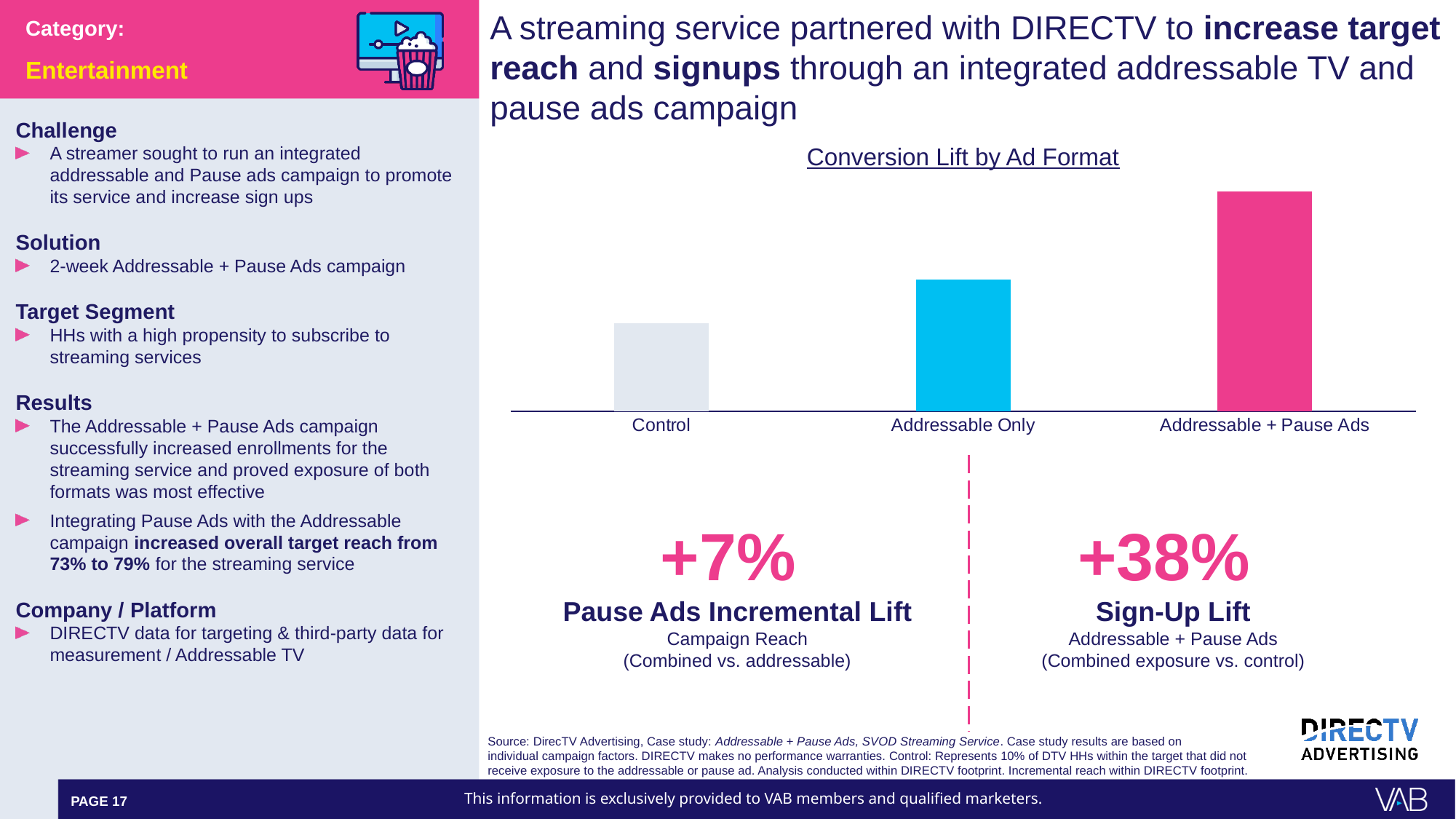
Do the bars rise or fall from left to right across the chart? rise What is the label of the middle category on the x axis? Addressable Only Which bar is taller, Control or Addressable Only? Addressable Only What is the title of the chart? Conversion Lift by Ad Format How many categories are plotted in the chart? 3 What kind of chart is shown on the slide? bar chart What colour is the bar for Addressable + Pause Ads? pink Which category has the highest bar in the chart? Addressable + Pause Ads Which category has the lowest bar in the chart? Control Which bar is taller, Addressable Only or Addressable + Pause Ads? Addressable + Pause Ads